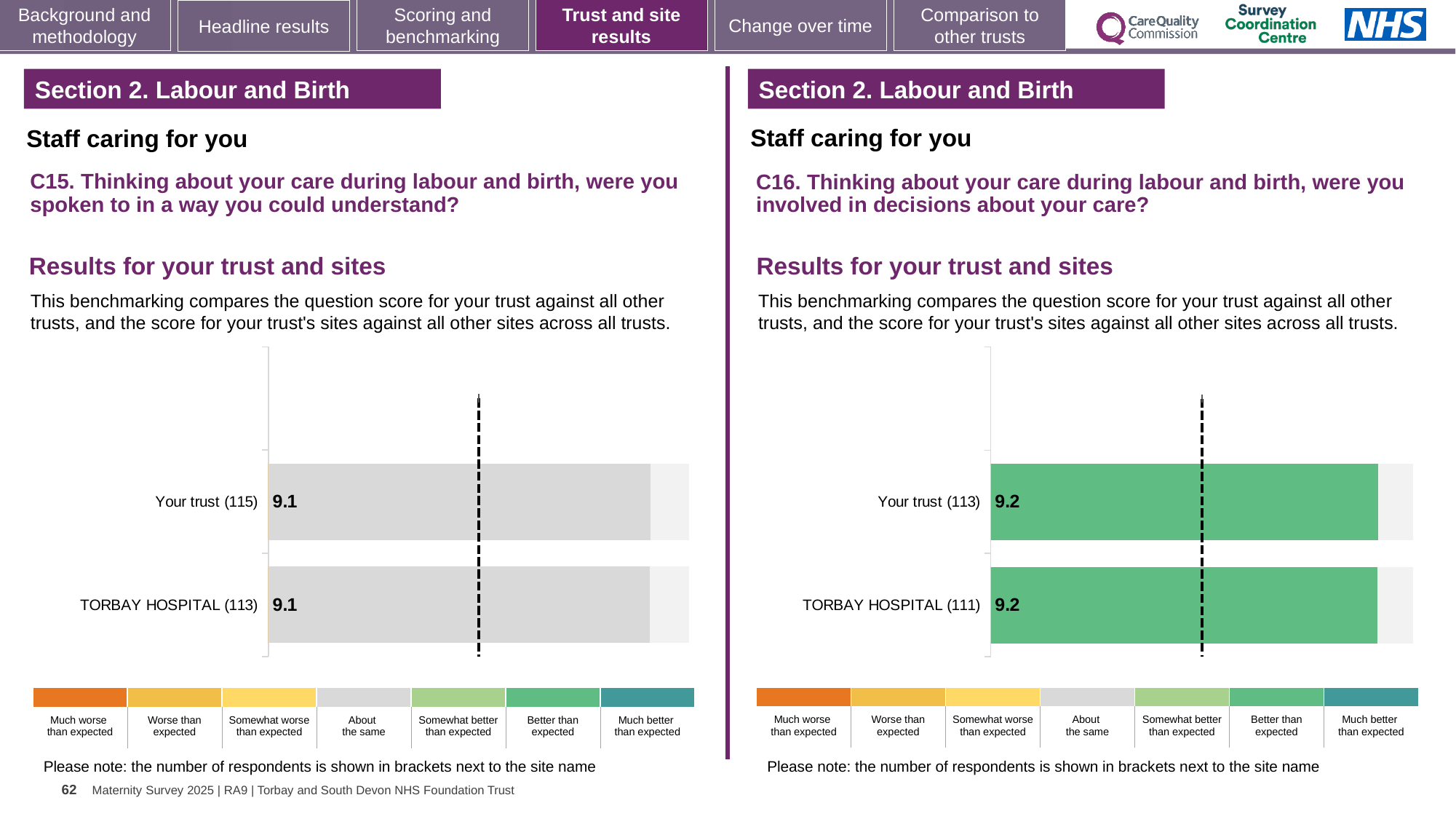
On the C15 chart (left), what is the difference between the score for Your trust and the score for TORBAY HOSPITAL? 0 On the C16 chart (right), what is the score for TORBAY HOSPITAL (111)? 9.2 How many respondents are shown in brackets for Your trust on the C16 chart (right)? 113 How many bars are plotted on the C16 chart (right)? 2 What kind of chart is used on the C16 chart (right)? Bar chart On the C15 chart (left), what is the score for Your trust (115)? 9.1 On the C15 chart (left), what is the score for TORBAY HOSPITAL (113)? 9.1 How many bars are plotted on the C15 chart (left)? 2 On the C16 chart (right), which benchmark category does the colour of the bars correspond to according to the legend? Better than expected On the C16 chart (right), what is the difference between the score for Your trust and the score for TORBAY HOSPITAL? 0 On the C15 chart (left), which benchmark category does the colour of the bars correspond to according to the legend? About the same On the C16 chart (right), what is the score for Your trust (113)? 9.2